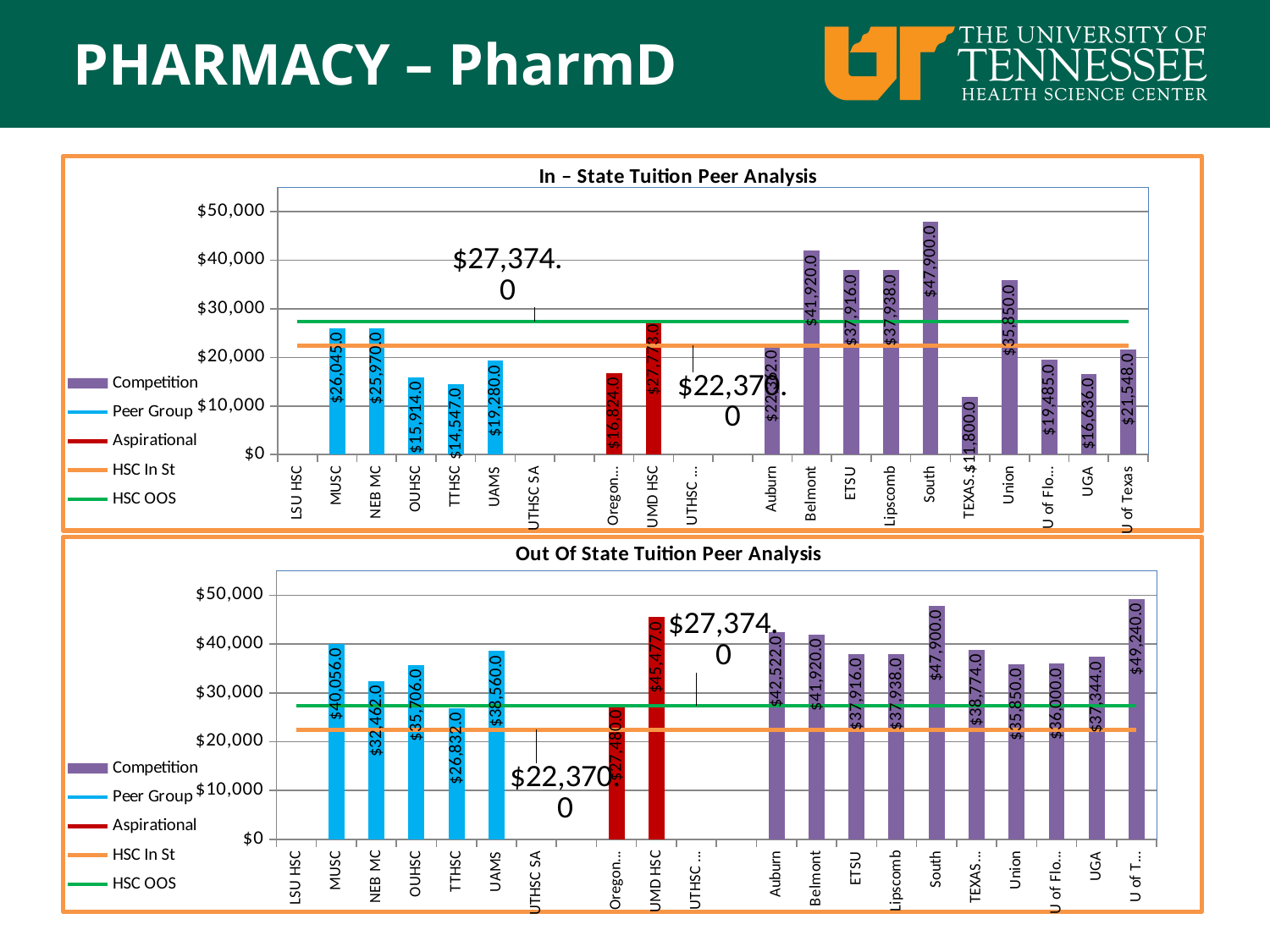
In the In – State Tuition Peer Analysis chart, which institution has the highest bar? South In the In – State Tuition Peer Analysis chart, what is the value for MUSC? $26,045.0 In the Out Of State Tuition Peer Analysis chart, which is larger, MUSC or NEB MC? MUSC In the Out Of State Tuition Peer Analysis chart, what is the value for UAMS? $38,560.0 How many entries does the legend of the Out Of State Tuition Peer Analysis chart list? 5 In the Out Of State Tuition Peer Analysis chart, what is the value of the highest bar? $49,240.0 In the In – State Tuition Peer Analysis chart, which of the blue Peer Group bars is the lowest? TTHSC What kind of chart is the In – State Tuition Peer Analysis chart? bar chart In the In – State Tuition Peer Analysis chart, what is the difference between Belmont and ETSU? $4,004.0 In the Out Of State Tuition Peer Analysis chart, what is the value for UMD HSC? $45,477.0 In the In – State Tuition Peer Analysis chart, what value is labelled on the green HSC OOS line? $27,374.0 In the In – State Tuition Peer Analysis chart, is the value for Union greater or less than $30,000? greater